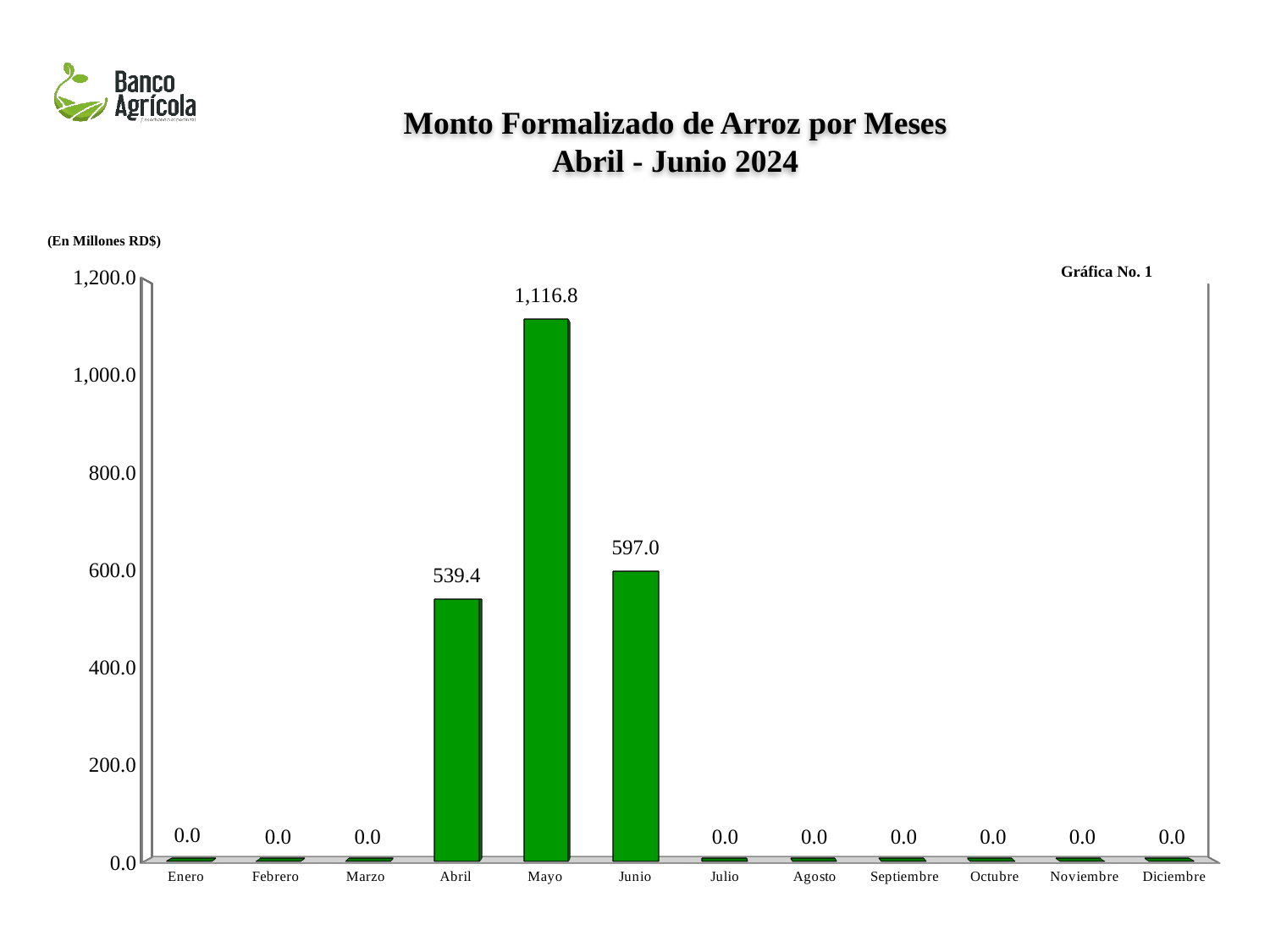
What is the value for Mayo? 1,116.8 What is the difference between the values for Junio and Abril? 57.6 What is the value for Abril? 539.4 What kind of chart is shown? bar chart What unit is stated for the values in the chart? En Millones RD$ Which is larger, the value for Abril or the value for Junio? Junio Is the value for Mayo greater or less than 1,000.0? greater What is the value for Junio? 597.0 What is the difference between the values for Mayo and Junio? 519.8 Which month has the highest value? Mayo How many months are shown on the x axis? 12 What is the value for Enero? 0.0